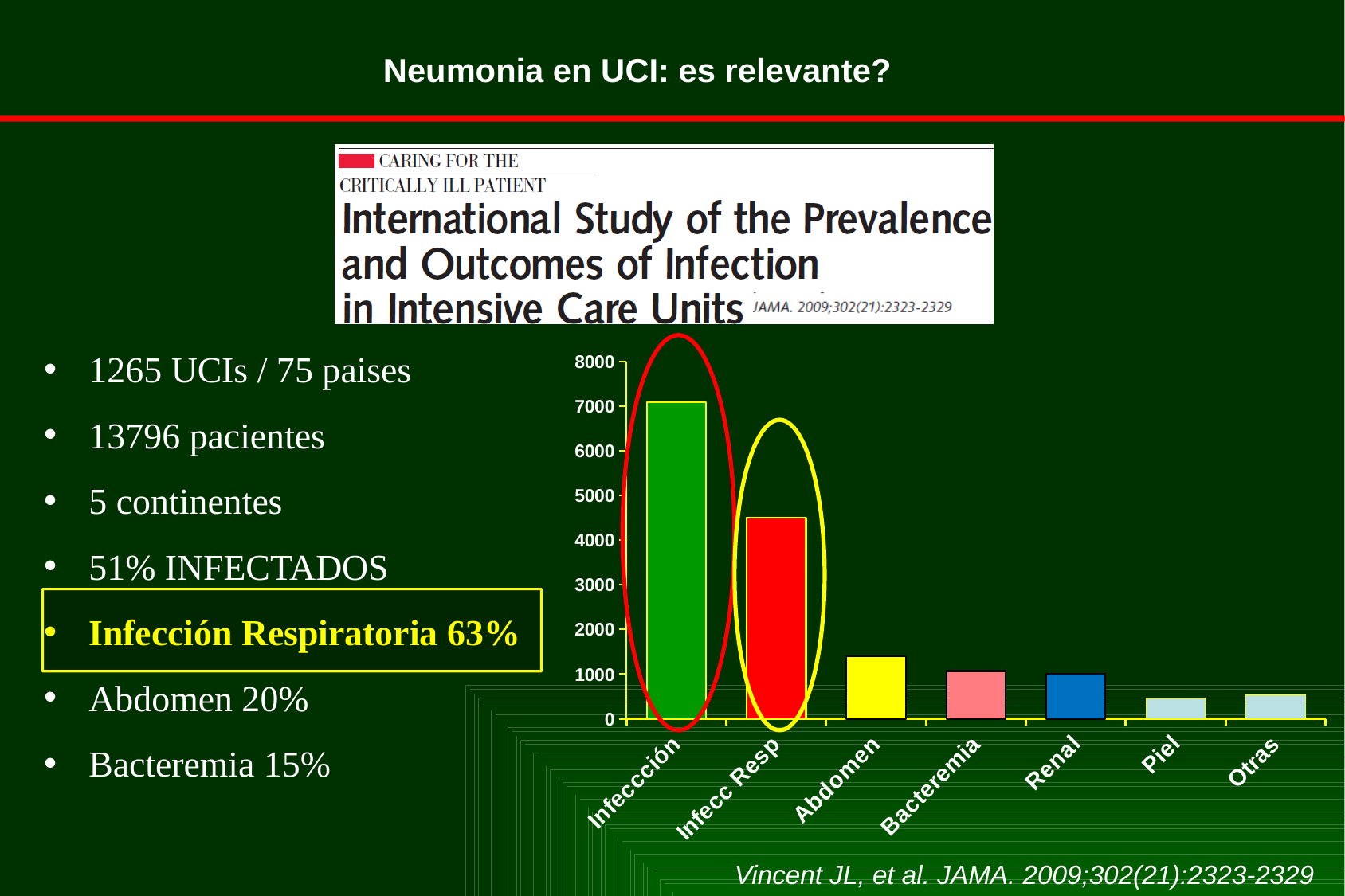
Which is larger, the value for Abdomen or the value for Renal? Abdomen What colour is the bar for Infecc Resp? red Is the value for Infecc Resp greater or less than 5000? less Is the value for Infecc Resp greater or less than 4000? greater Which category has the highest bar in the chart? Infeccción How many categories are shown on the x axis of the chart? 7 Is the value for Abdomen greater or less than 1000? greater Which is larger, the value for Infeccción or the value for Infecc Resp? Infeccción Do the bar values generally rise or fall from left to right along the x axis? fall What kind of chart is shown on the slide? bar chart